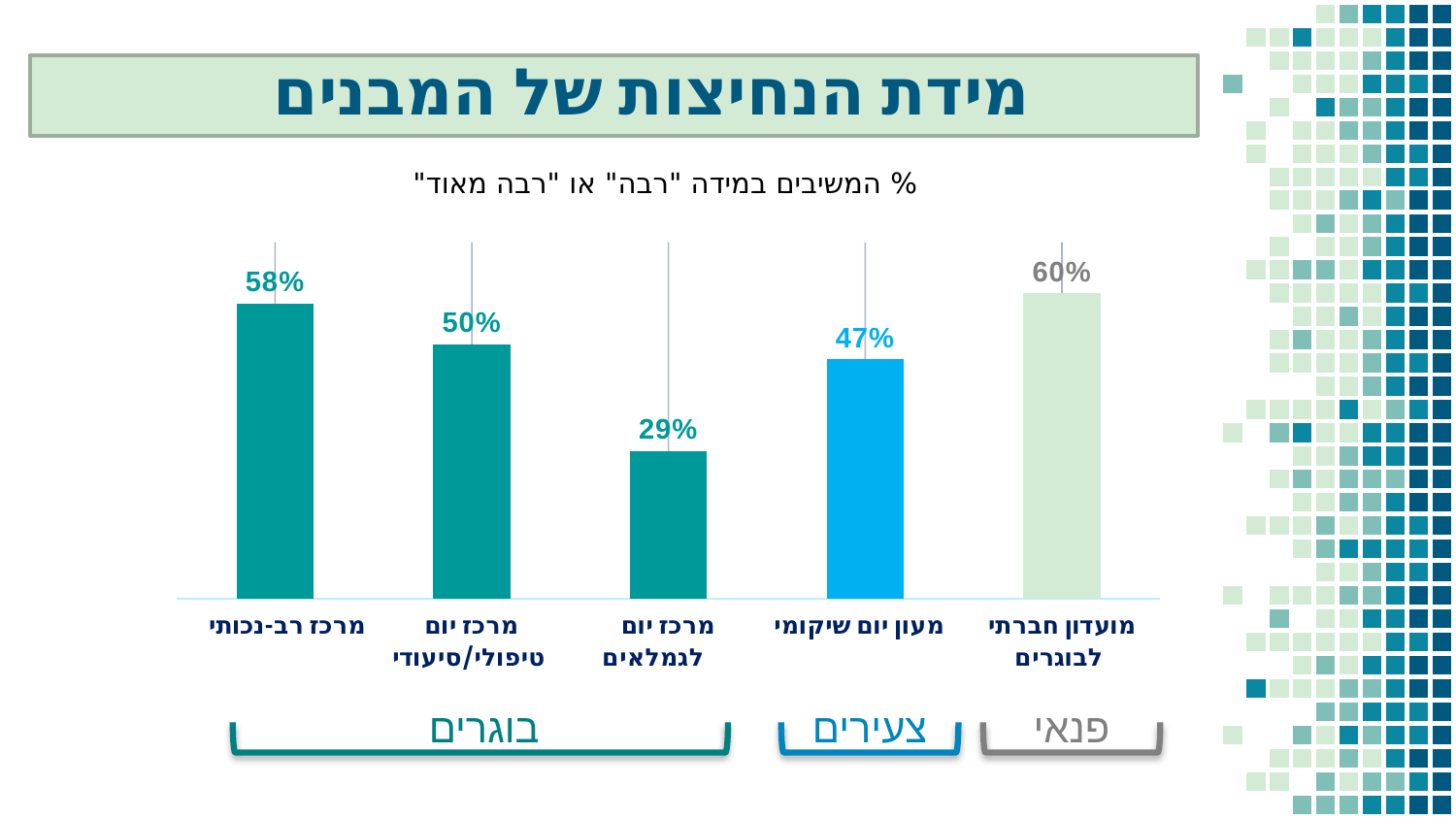
What is the value for מרכז יום טיפולי/סיעודי? 50% What is the value for מועדון חברתי לבוגרים? 60% Which group label is shown under the bar for מעון יום שיקומי? צעירים How many categories are shown in the chart? 5 What kind of chart is shown on the slide? Bar chart What is the difference between the values for מרכז רב-נכותי and מרכז יום לגמלאים? 29% Which is larger, the value for מרכז יום טיפולי/סיעודי or the value for מעון יום שיקומי? מרכז יום טיפולי/סיעודי What is the value for מעון יום שיקומי? 47% Which category has the highest value? מועדון חברתי לבוגרים Which category has the lowest value? מרכז יום לגמלאים What is the value for מרכז רב-נכותי? 58% What is the value for מרכז יום לגמלאים? 29%